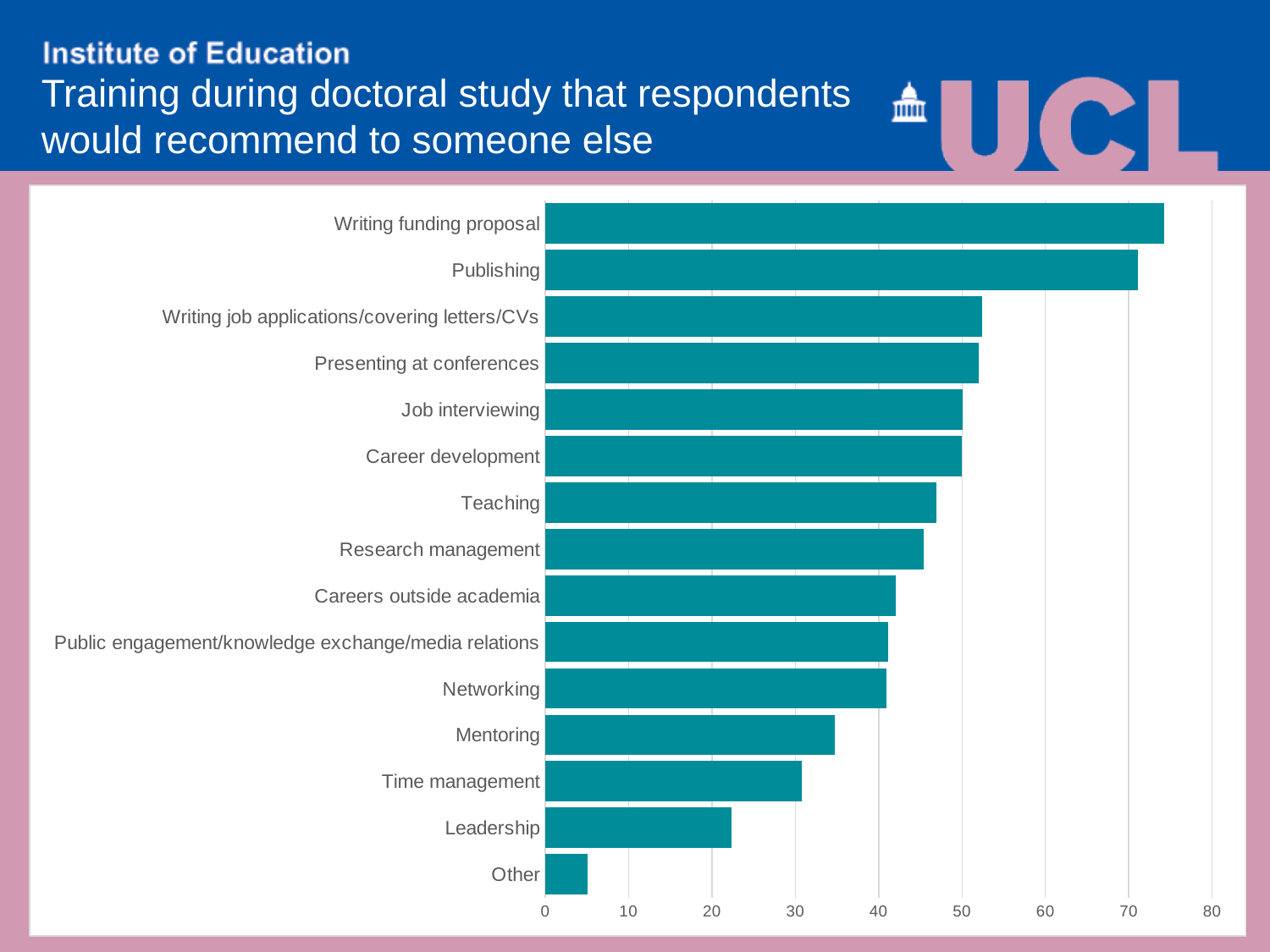
What is the title of the slide containing the chart? Training during doctoral study that respondents would recommend to someone else Which has a larger value, Mentoring or Time management? Mentoring Is the value for Publishing greater or less than 60? greater What kind of chart is shown on the slide? bar chart How many training categories are listed on the chart? 15 Is the value for Mentoring greater or less than 40? less Is the value for Teaching greater or less than 50? less Which training category has the highest value? Writing funding proposal Which training category has the lowest value? Other